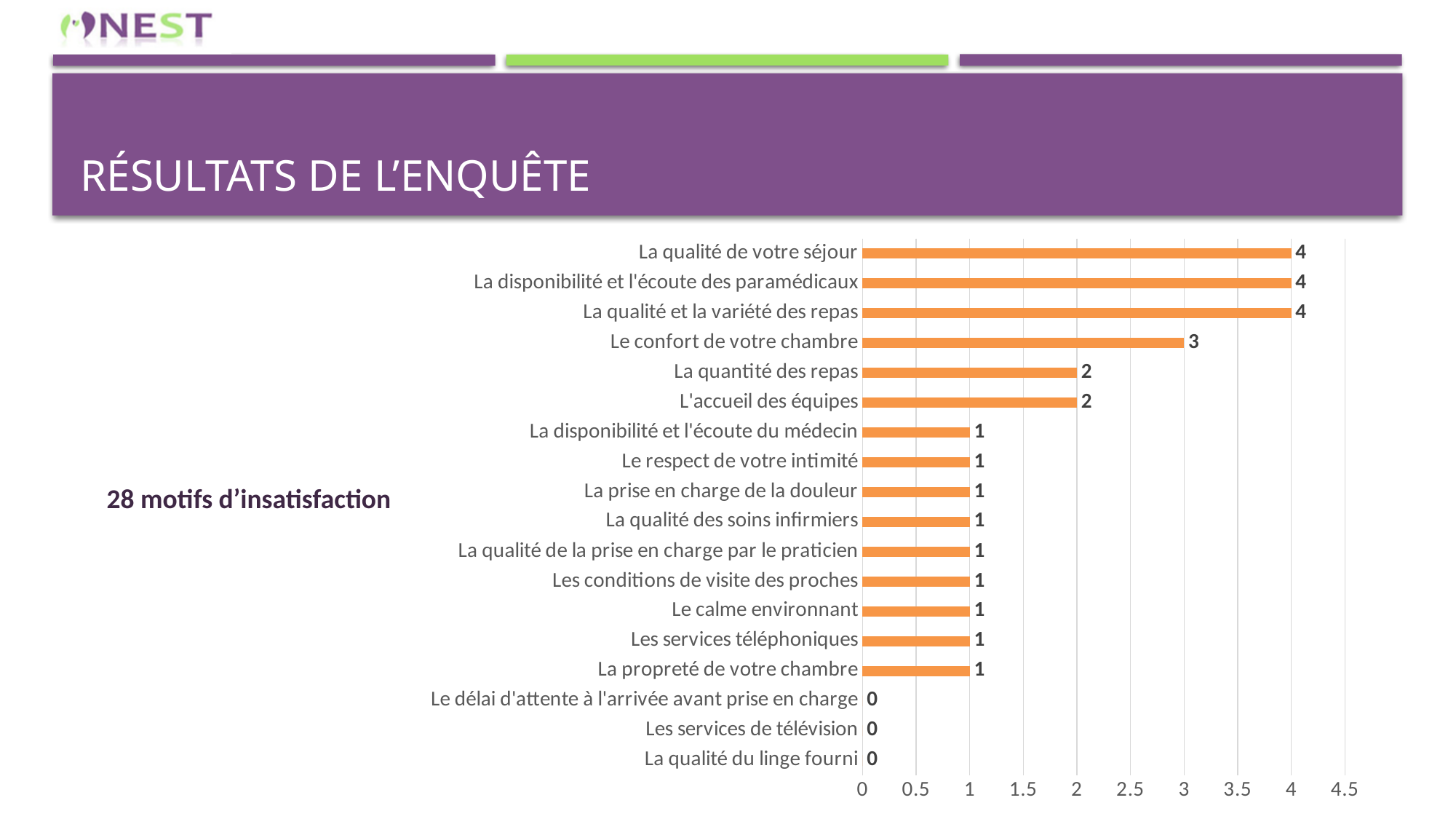
What value is shown for "Le confort de votre chambre"? 3 What value is shown for "Les services de télévision"? 0 How many categories are shown on the chart? 18 What colour are the bars in the chart? Orange What is the difference between the values for "Le confort de votre chambre" and "L'accueil des équipes"? 1 Which is larger, the value for "La quantité des repas" or the value for "Le respect de votre intimité"? La quantité des repas What is the difference between the values for "La qualité de votre séjour" and "Le confort de votre chambre"? 1 What value is shown for "Les services téléphoniques"? 1 How many categories have a value of 0? 3 What value is shown for "La quantité des repas"? 2 What kind of chart is shown on the slide? Bar chart Which is larger, the value for "Le confort de votre chambre" or the value for "La qualité et la variété des repas"? La qualité et la variété des repas